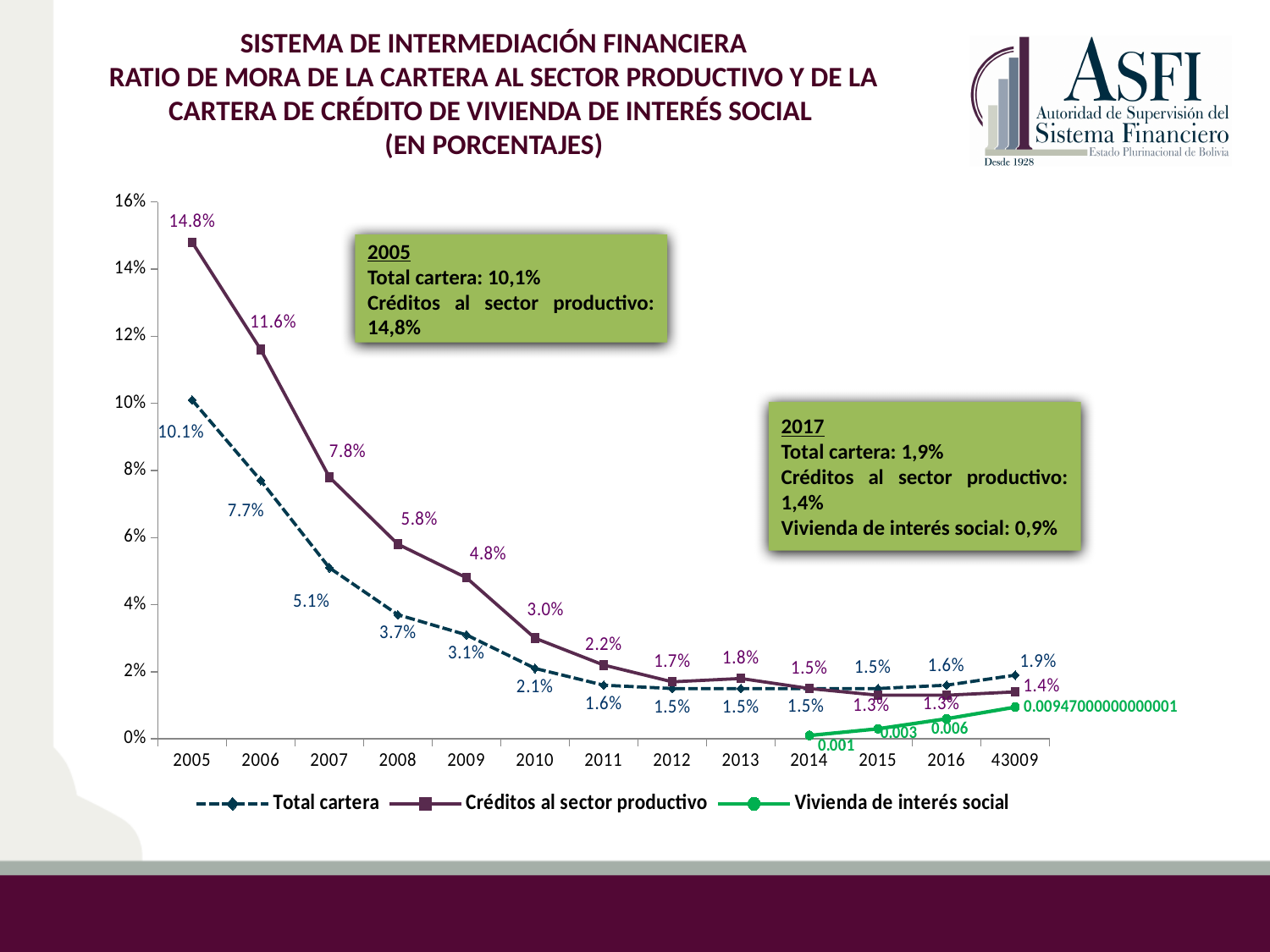
How many series does the legend list? 3 Which is larger in 2007, Total cartera or Créditos al sector productivo? Créditos al sector productivo How many x-axis categories are plotted on the chart? 13 What is the value of Créditos al sector productivo in 2005? 14.8% What is the value of Créditos al sector productivo in 2010? 3.0% What is the value of Vivienda de interés social in 2015? 0.003 Is the value of Total cartera in 2006 greater or less than 8%? less What type of chart is shown on the slide? line chart Does Créditos al sector productivo rise or fall from 2005 to 2010? fall In which year is Créditos al sector productivo highest? 2005 What is the difference between Créditos al sector productivo and Total cartera in 2005? 4.7% What is the value of Total cartera in 2008? 3.7%